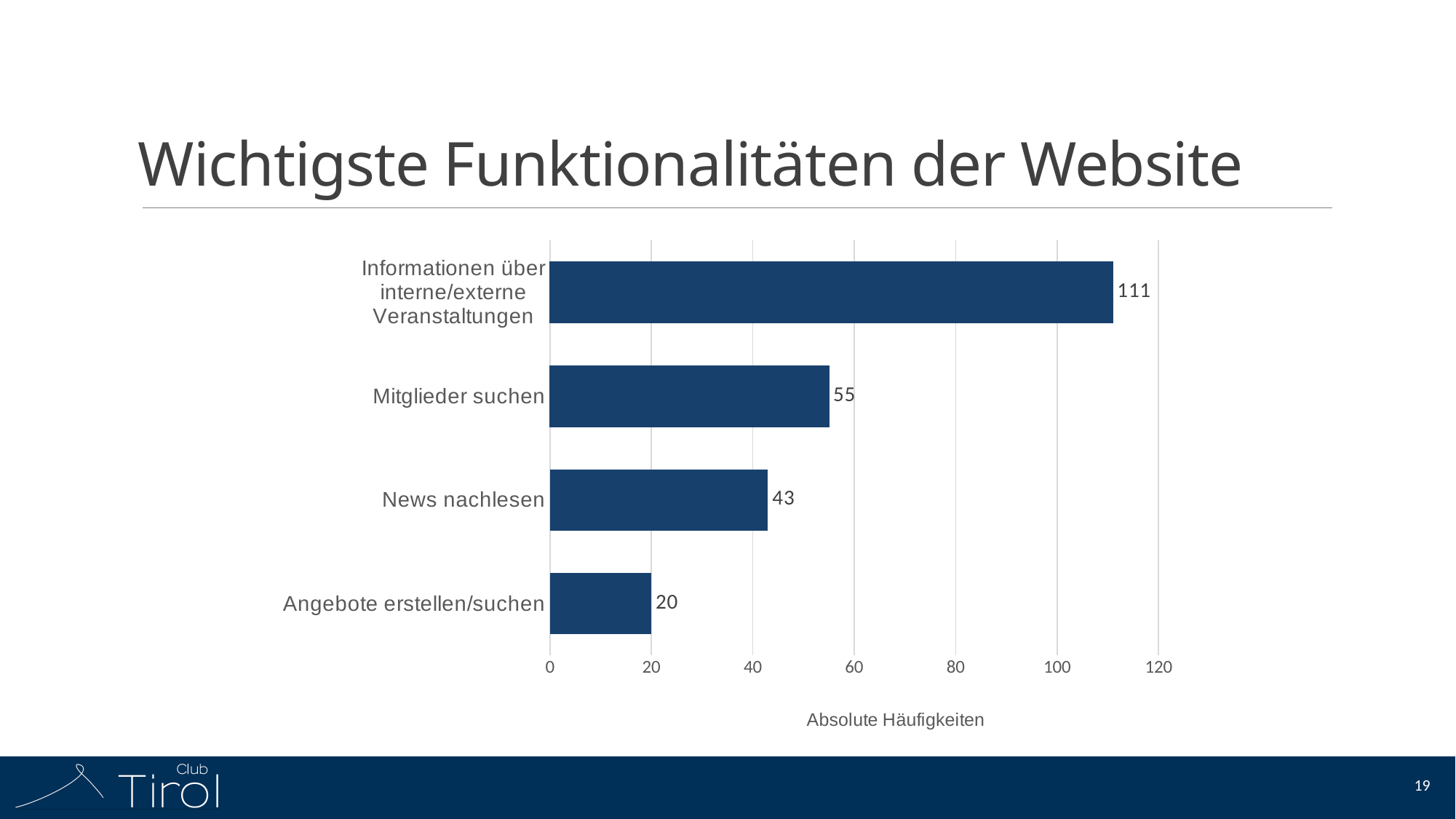
Which is larger, the value for "News nachlesen" or the value for "Angebote erstellen/suchen"? News nachlesen What is the value for "Mitglieder suchen"? 55 Which category has the highest value? Informationen über interne/externe Veranstaltungen How many categories are shown in the chart? 4 What kind of chart is shown on the slide? Bar chart What is the difference between the values for "Mitglieder suchen" and "News nachlesen"? 12 Is the value for "Mitglieder suchen" greater or less than 60? less Which category has the lowest value? Angebote erstellen/suchen What is the difference between the values for "Informationen über interne/externe Veranstaltungen" and "Angebote erstellen/suchen"? 91 What is the value for "Informationen über interne/externe Veranstaltungen"? 111 What is the value for "Angebote erstellen/suchen"? 20 What is the value for "News nachlesen"? 43